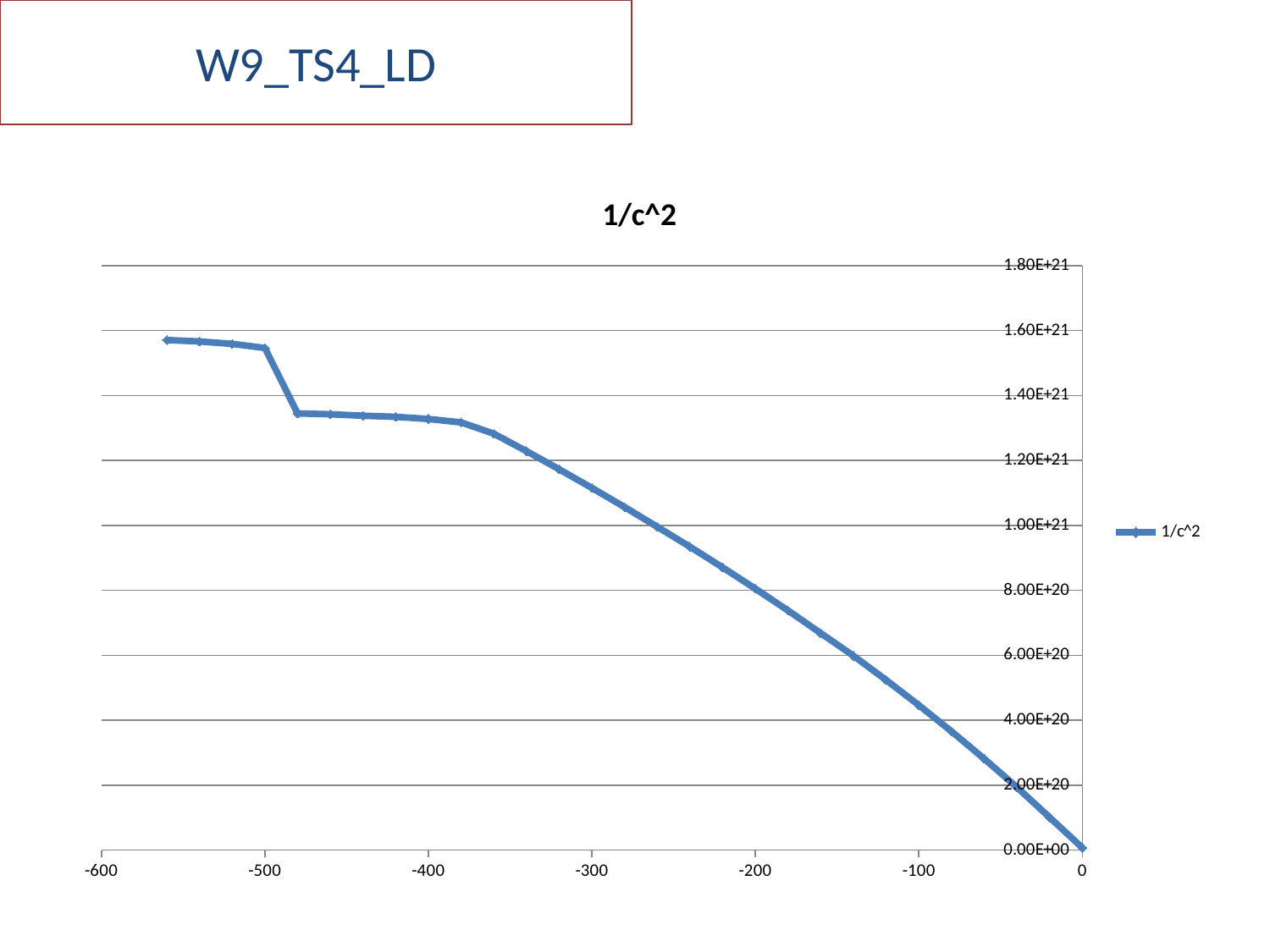
Is the value at x = -300 greater or less than 1.00E+21? greater How many series does the legend list? 1 Is the value at x = -400 greater or less than 1.20E+21? greater Do the plotted values rise or fall as the x axis goes from -600 to 0? fall Is the value at x = -500 greater or less than 1.40E+21? greater What kind of chart is shown on the slide? line chart What is the title of the chart? 1/c^2 Which of the two x positions has the larger value, x = -500 or x = -400? x = -500 What is the name of the series shown in the legend? 1/c^2